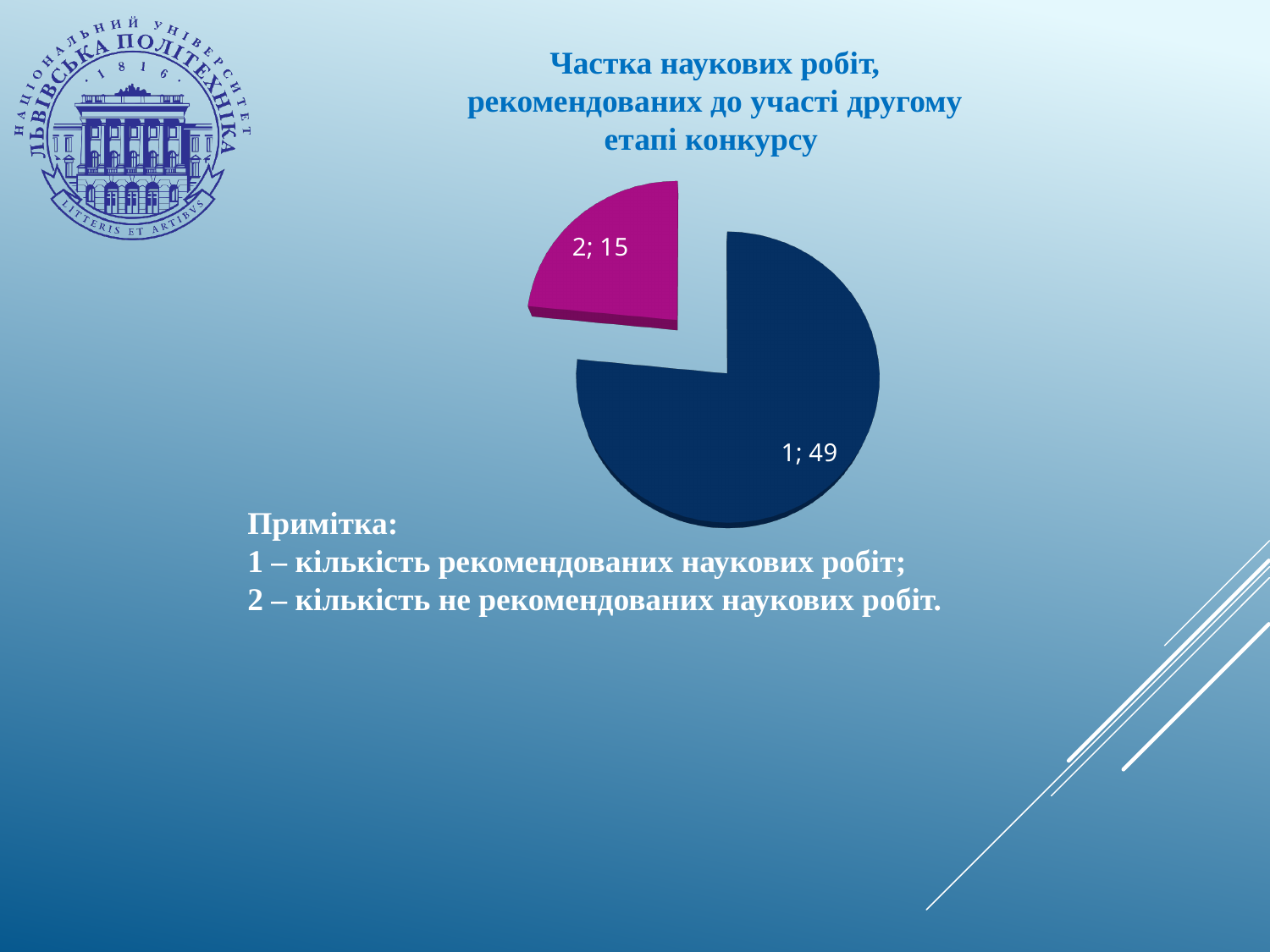
What kind of chart is shown on the slide? pie chart What is the title of the chart? Частка наукових робіт, рекомендованих до участі другому етапі конкурсу Which slice of the pie chart is the smallest? 2 Which is larger, the value of slice 1 or slice 2? 1 What is the value of slice 1 in the pie chart? 49 How many slices does the pie chart have? 2 What colour is the slice labelled 2 in the pie chart? magenta What is the difference between the values of slice 1 and slice 2? 34 What is the value of slice 2 in the pie chart? 15 Which slice of the pie chart is the largest? 1 What is the total of all slices in the pie chart? 64 According to the note, what does slice 1 represent? кількість рекомендованих наукових робіт